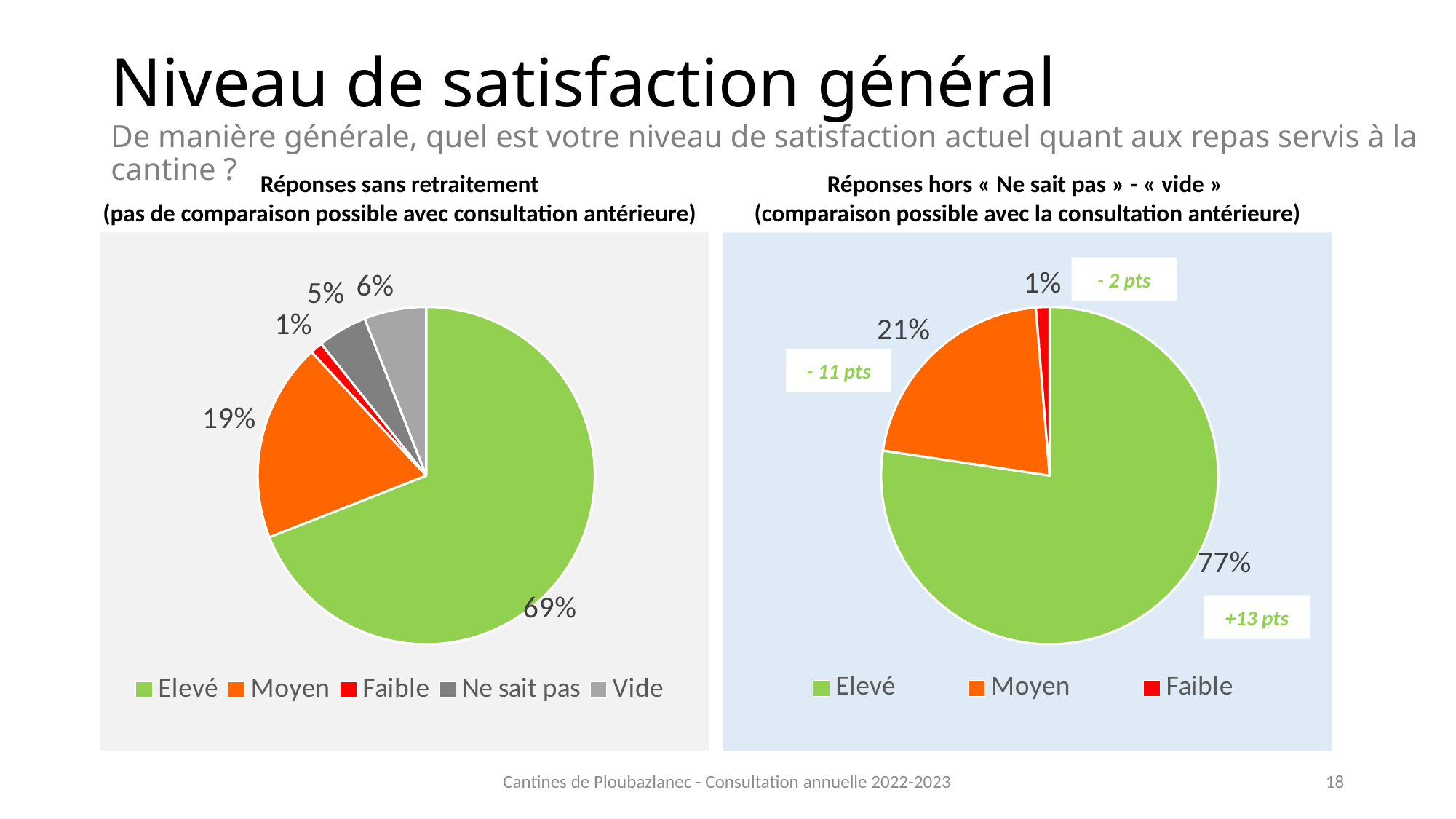
What type of chart is used on the right side of the slide? Pie chart How many categories does the legend of the right chart (Réponses hors « Ne sait pas » - « vide ») list? 3 What is the difference in percentage points between Elevé in the right chart and Elevé in the left chart? 8 In the left chart (Réponses sans retraitement), what percentage is shown for Vide? 6% In the right chart (Réponses hors « Ne sait pas » - « vide »), what percentage is shown for Elevé? 77% How many categories does the legend of the left chart (Réponses sans retraitement) list? 5 In the right chart (Réponses hors « Ne sait pas » - « vide »), which category has the largest share? Elevé In the left chart (Réponses sans retraitement), which category has the smallest share? Faible In the left chart (Réponses sans retraitement), what percentage is shown for Moyen? 19% In the left chart (Réponses sans retraitement), what percentage is shown for Ne sait pas? 5% In the right chart (Réponses hors « Ne sait pas » - « vide »), what percentage is shown for Moyen? 21% In the left chart (Réponses sans retraitement), what percentage is shown for Elevé? 69%